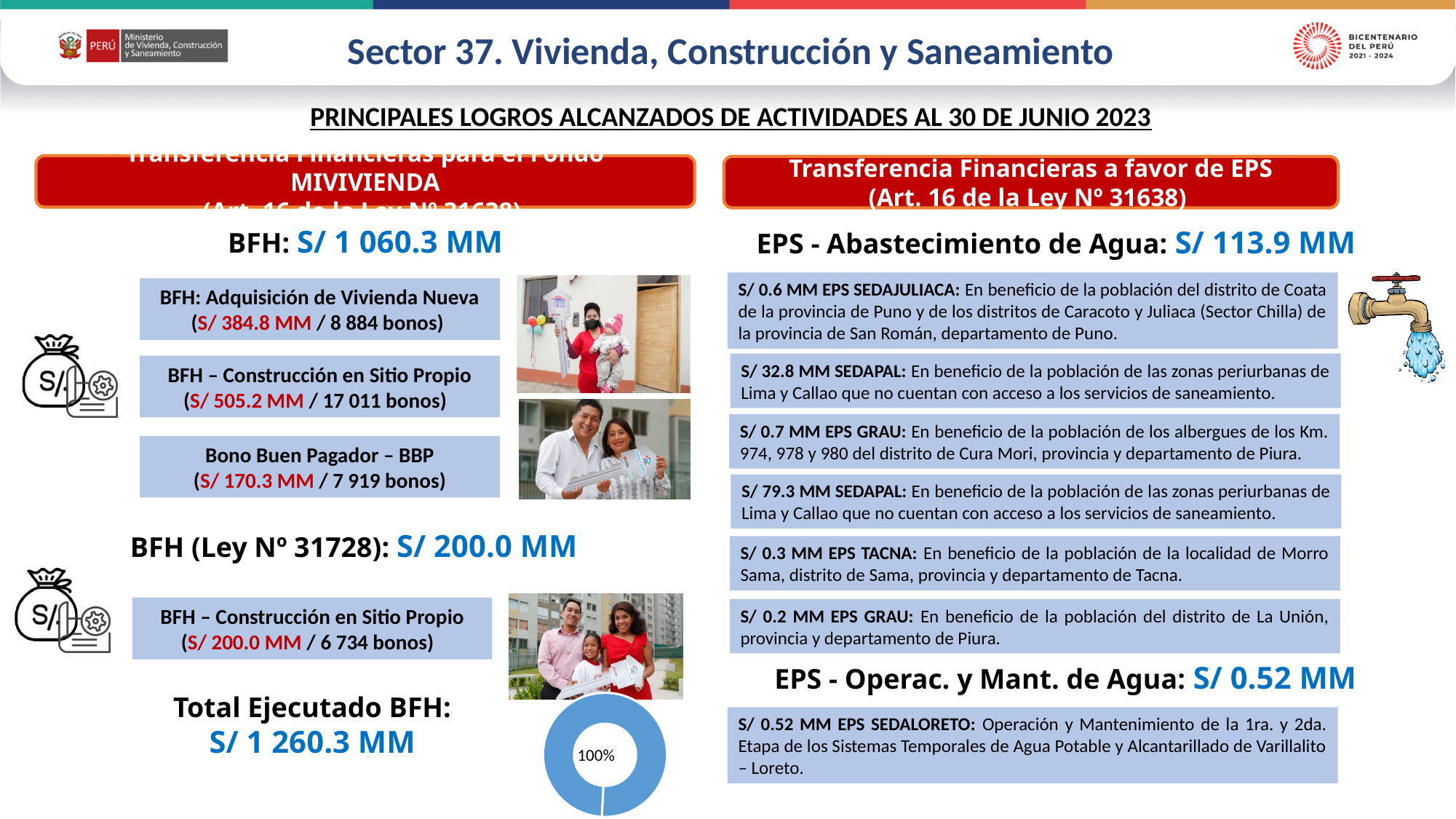
What percentage label is printed on the doughnut chart at the bottom of the slide? 100% What share of the doughnut chart at the bottom of the slide does its single slice take up? 100% How many slices does the doughnut chart at the bottom of the slide show? 1 What colour is the slice of the doughnut chart at the bottom of the slide? blue What kind of chart is shown at the bottom of the slide, below the photos? doughnut chart